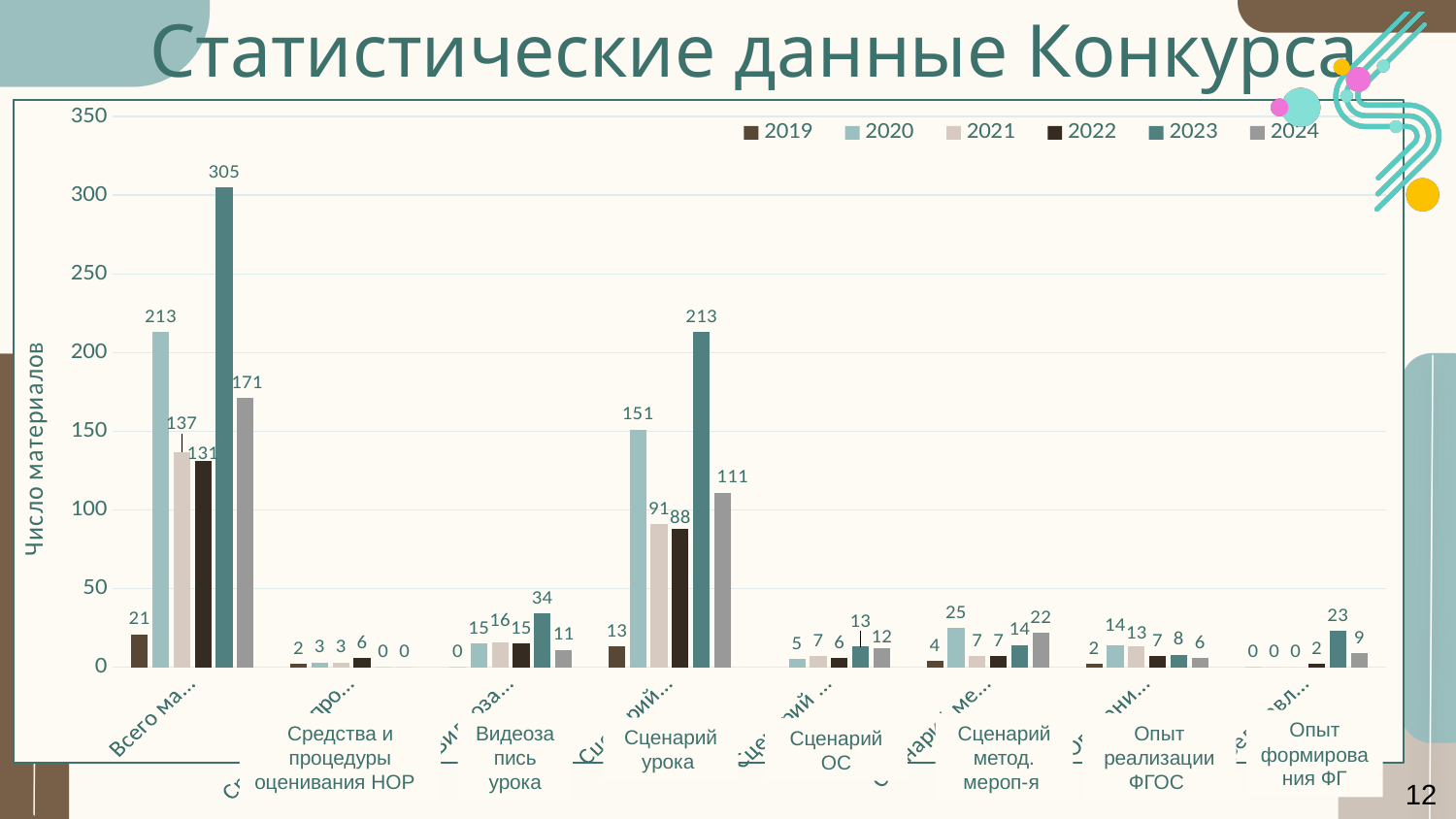
What is the highest value shown in the leftmost category group of the chart? 305 What is the value for 2023 in the 'Сценарий урока' category? 213 What is the value for 2020 in the 'Сценарий метод. мероп-я' category? 25 What is the value for 2024 in the 'Опыт формирования ФГ' category? 9 Which year has the lowest value in the 'Опыт реализации ФГОС' category? 2019 In the 'Сценарий метод. мероп-я' category, which is larger: the value for 2020 or the value for 2024? 2020 What is the title of the chart? Статистические данные Конкурса Which year has the highest value in the 'Видеозапись урока' category? 2023 What is the difference between the 2023 and 2024 values in the 'Сценарий урока' category? 102 Is the 2020 value in the 'Сценарий урока' category greater or less than 150? greater What type of chart is shown on the slide? bar chart How many series does the legend list? 6